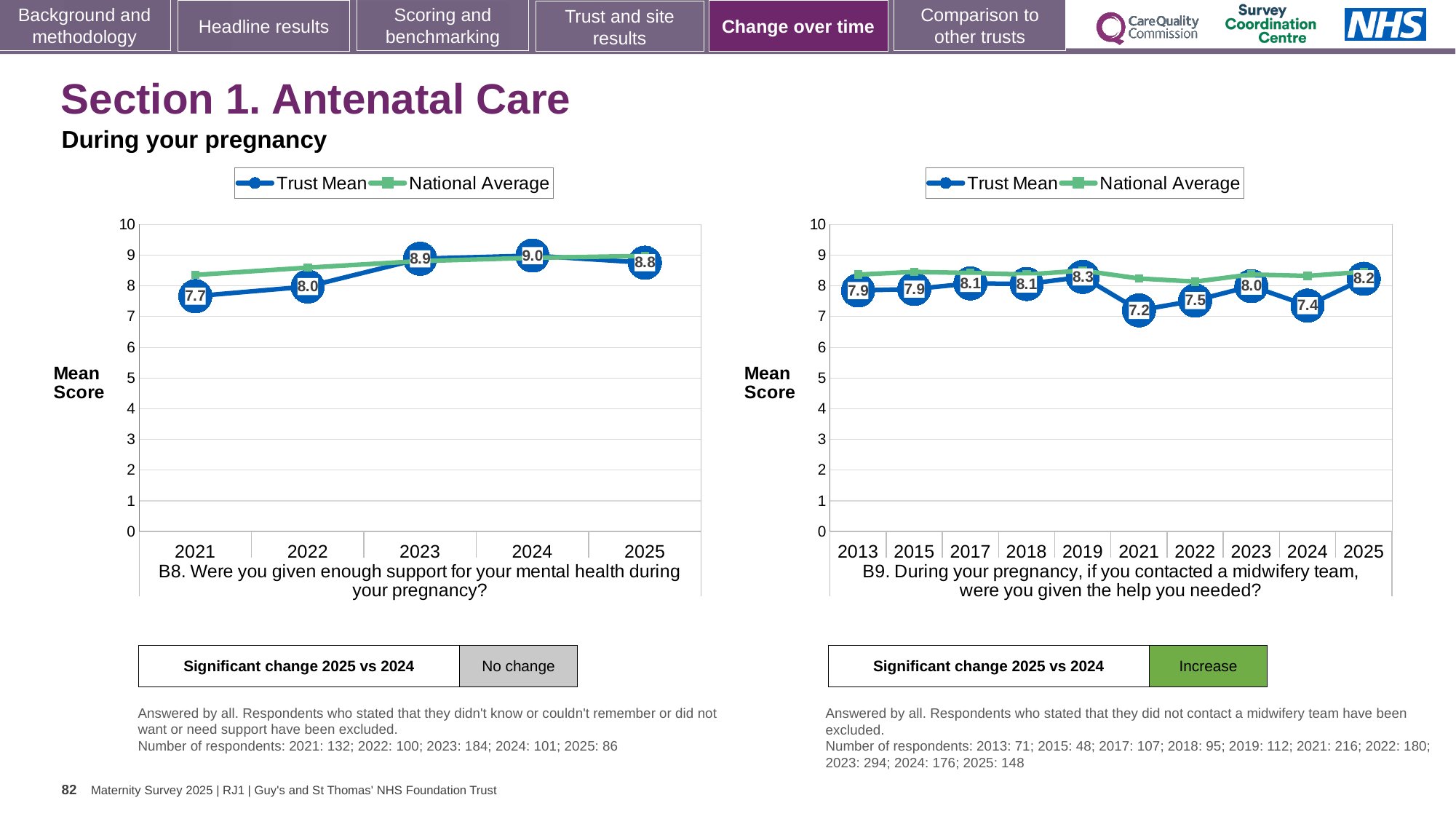
In the B9 chart on the right, what is the Trust Mean for 2021? 7.2 In the B9 chart on the right, is the Trust Mean for 2024 or 2023 larger? 2023 In the B9 chart on the right, how many series does the legend list? 2 In the B8 chart on the left, what is the Trust Mean for 2024? 9.0 In the B8 chart on the left, how many years are shown on the x axis? 5 In the B8 chart on the left, what is the difference between the Trust Mean for 2024 and 2021? 1.3 In the B9 chart on the right, which year has the highest Trust Mean? 2019 In the B8 chart on the left, which year has the lowest Trust Mean? 2021 In the B8 chart on the left, what is the Trust Mean for 2021? 7.7 What type of chart is the B9 chart on the right? Line chart In the B8 chart on the left, is the National Average for 2021 greater or less than 8? greater In the B9 chart on the right, what is the Trust Mean for 2025? 8.2